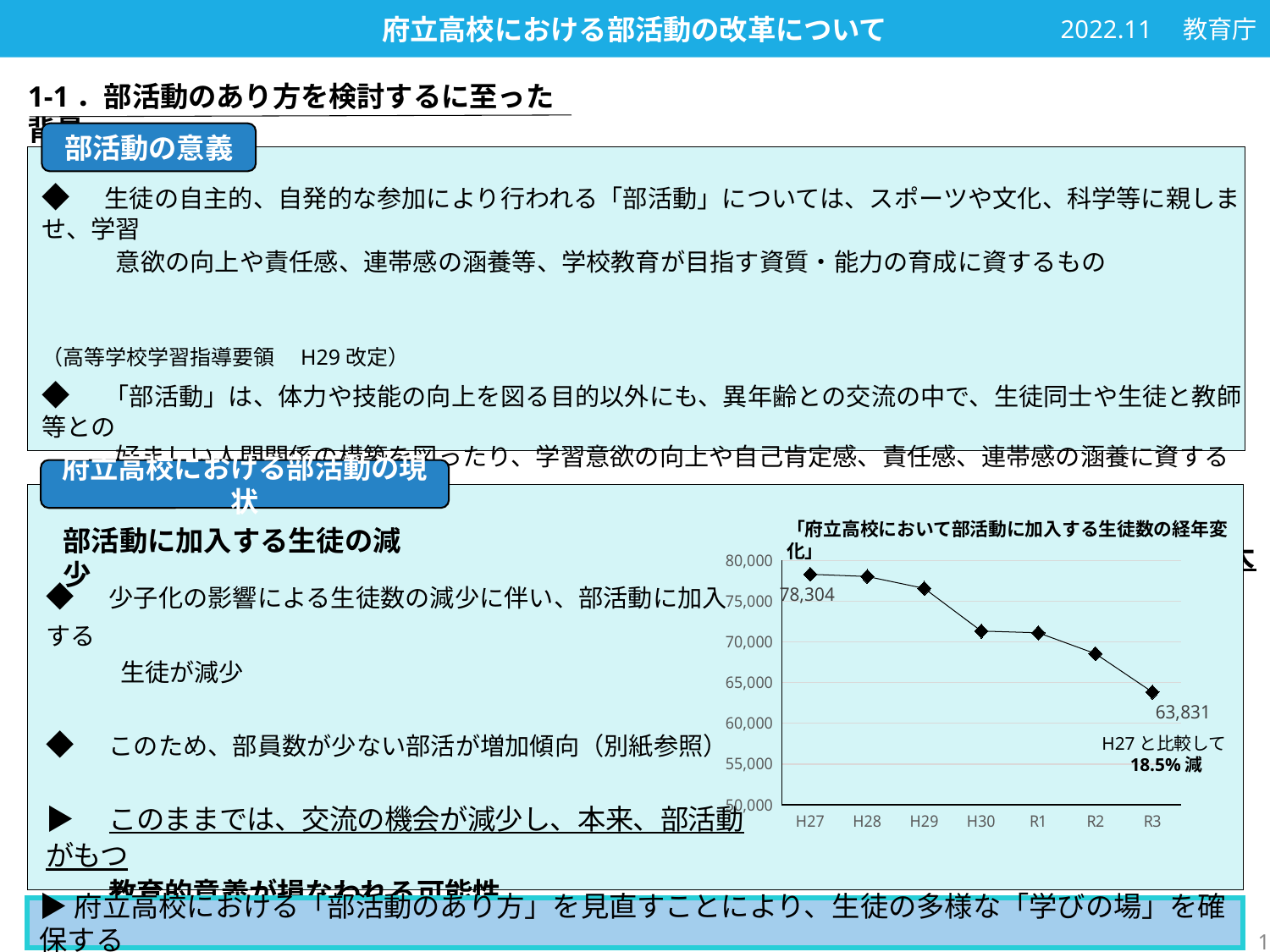
Which year has the highest value in the chart 「府立高校において部活動に加入する生徒数の経年変化」? H27 Do the values in the chart 「府立高校において部活動に加入する生徒数の経年変化」 rise or fall from H27 to R3? fall In the chart 「府立高校において部活動に加入する生徒数の経年変化」, which is larger, the value for H29 or the value for R2? H29 What is the value for R3 in the chart 「府立高校において部活動に加入する生徒数の経年変化」? 63,831 What is the value for H27 in the chart 「府立高校において部活動に加入する生徒数の経年変化」? 78,304 What kind of chart is 「府立高校において部活動に加入する生徒数の経年変化」? line chart How many years are plotted on the x axis of the chart 「府立高校において部活動に加入する生徒数の経年変化」? 7 Which year has the lowest value in the chart 「府立高校において部活動に加入する生徒数の経年変化」? R3 According to the annotation on the chart 「府立高校において部活動に加入する生徒数の経年変化」, by what percentage has the value decreased compared with H27? 18.5% In the chart 「府立高校において部活動に加入する生徒数の経年変化」, is the value for R2 greater or less than 70,000? less In the chart 「府立高校において部活動に加入する生徒数の経年変化」, is the value for H30 greater or less than 75,000? less What is the difference between the H27 value and the R3 value in the chart 「府立高校において部活動に加入する生徒数の経年変化」? 14,473